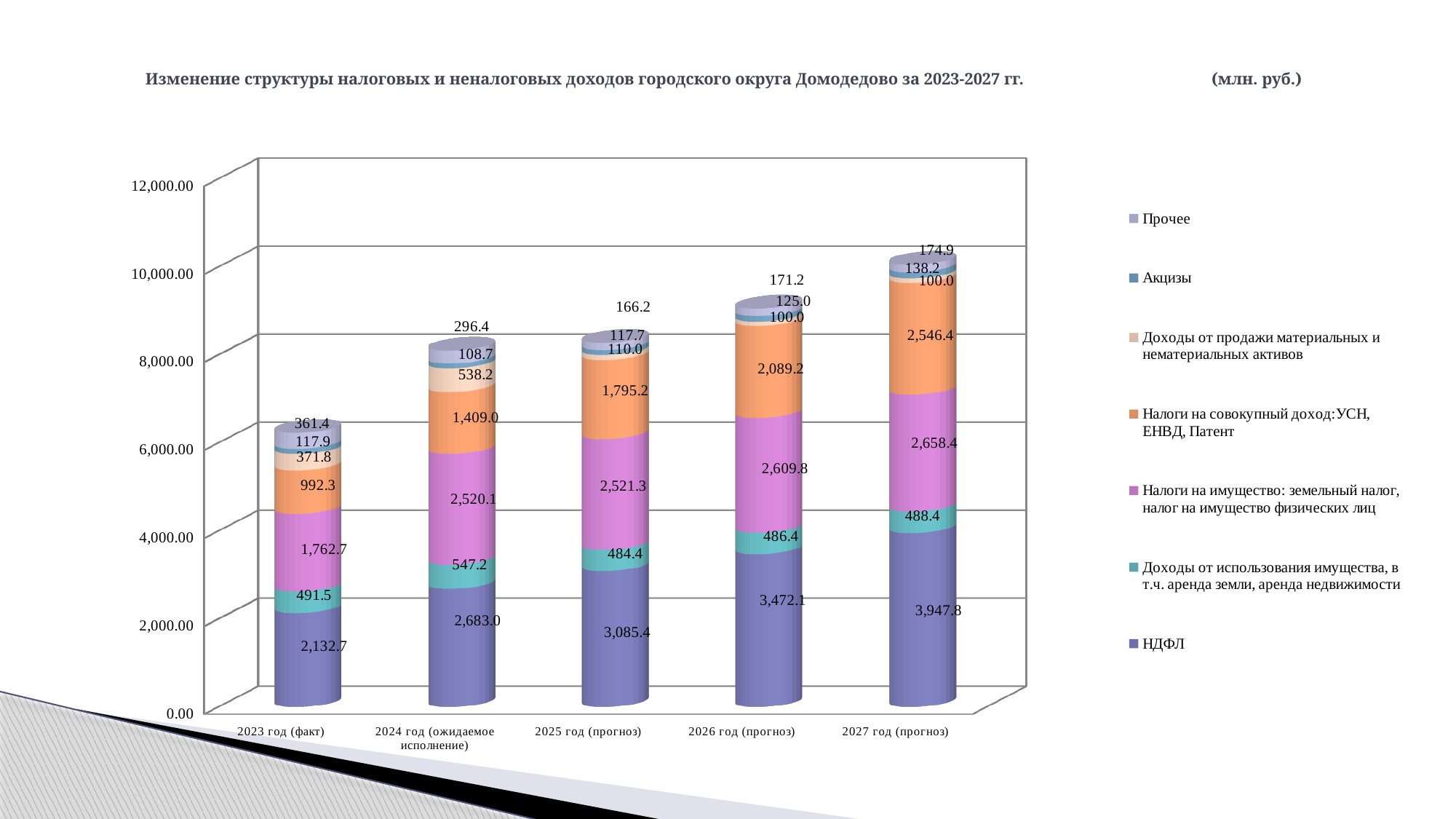
What is the difference between the НДФЛ value for 2027 год (прогноз) and for 2023 год (факт)? 1,815.1 In which year is the НДФЛ value the highest? 2027 год (прогноз) What is the value of Налоги на совокупный доход: УСН, ЕНВД, Патент for 2024 год (ожидаемое исполнение)? 1,409.0 Does the НДФЛ value rise or fall from 2023 to 2027? Rises For 2027 год (прогноз), which is larger: Налоги на имущество or Налоги на совокупный доход? Налоги на имущество What is the value of НДФЛ for 2027 год (прогноз)? 3,947.8 How many year categories are shown on the x axis? 5 In which year is the value of Налоги на имущество the lowest? 2023 год (факт) How many series does the legend list? 7 What kind of chart is shown on the slide? Stacked bar chart What is the value of Доходы от использования имущества for 2023 год (факт)? 491.5 What is the total of the stacked bar for 2024 год (ожидаемое исполнение)? 8,102.6